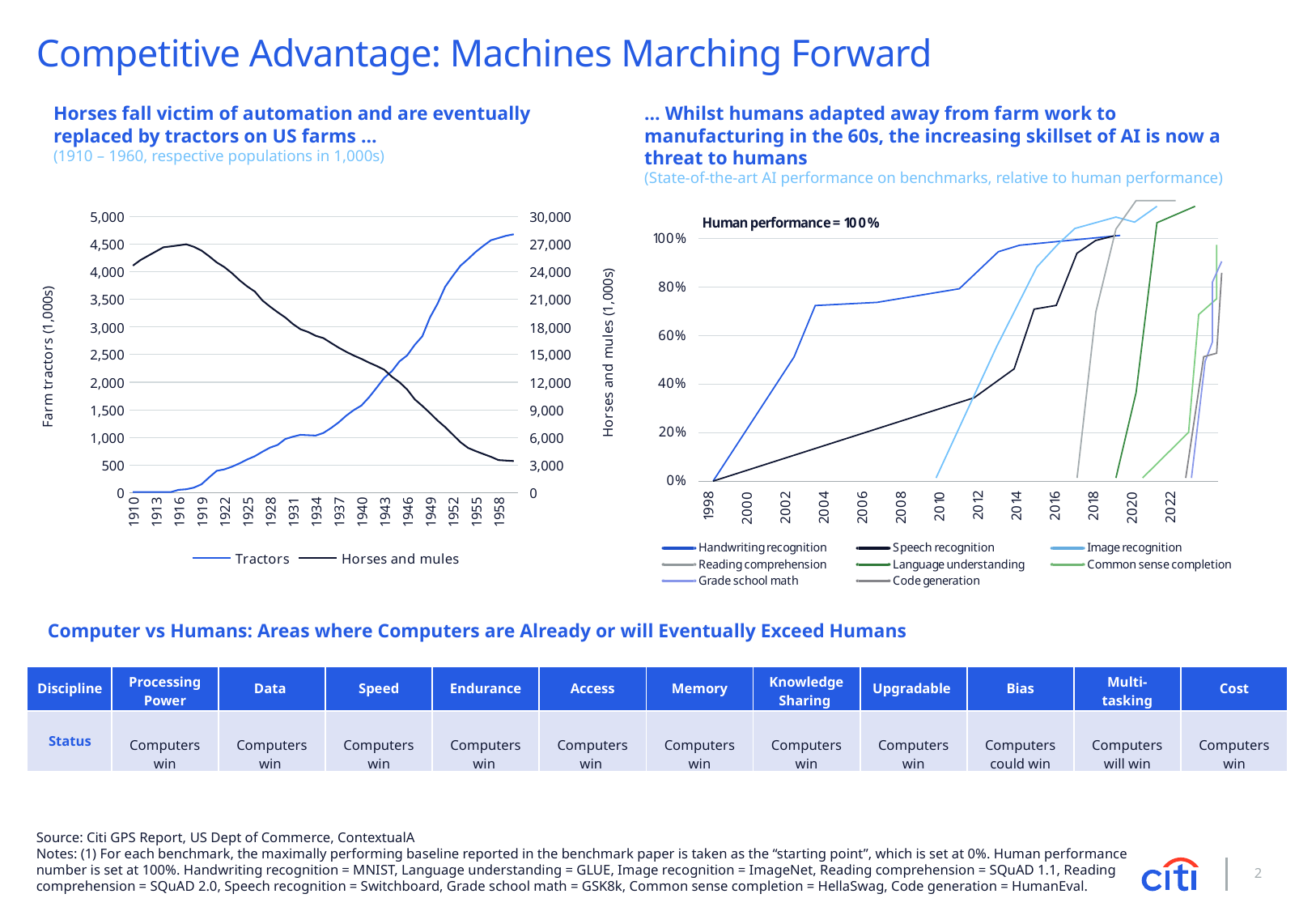
How many series does the legend of the left chart (tractors and horses and mules) list? 2 In the left chart, does the Horses and mules series rise or fall from 1916 to 1958? Fall What kind of chart is the left chart showing tractors and horses and mules on US farms? Line chart How many series does the legend of the right chart (AI performance on benchmarks) list? 8 In the right chart, is the value for Handwriting recognition in 2004 greater or less than 60%? greater What is the label of the right-hand vertical axis of the left chart? Horses and mules (1,000s) In the left chart, is the value for Tractors in 1946 greater or less than 2,000? greater What kind of chart is the right chart showing state-of-the-art AI performance on benchmarks? Line chart In the left chart, does the Tractors series rise or fall from 1910 to 1958? Rise In the left chart, is the value for Horses and mules in 1958 greater or less than 6,000? less